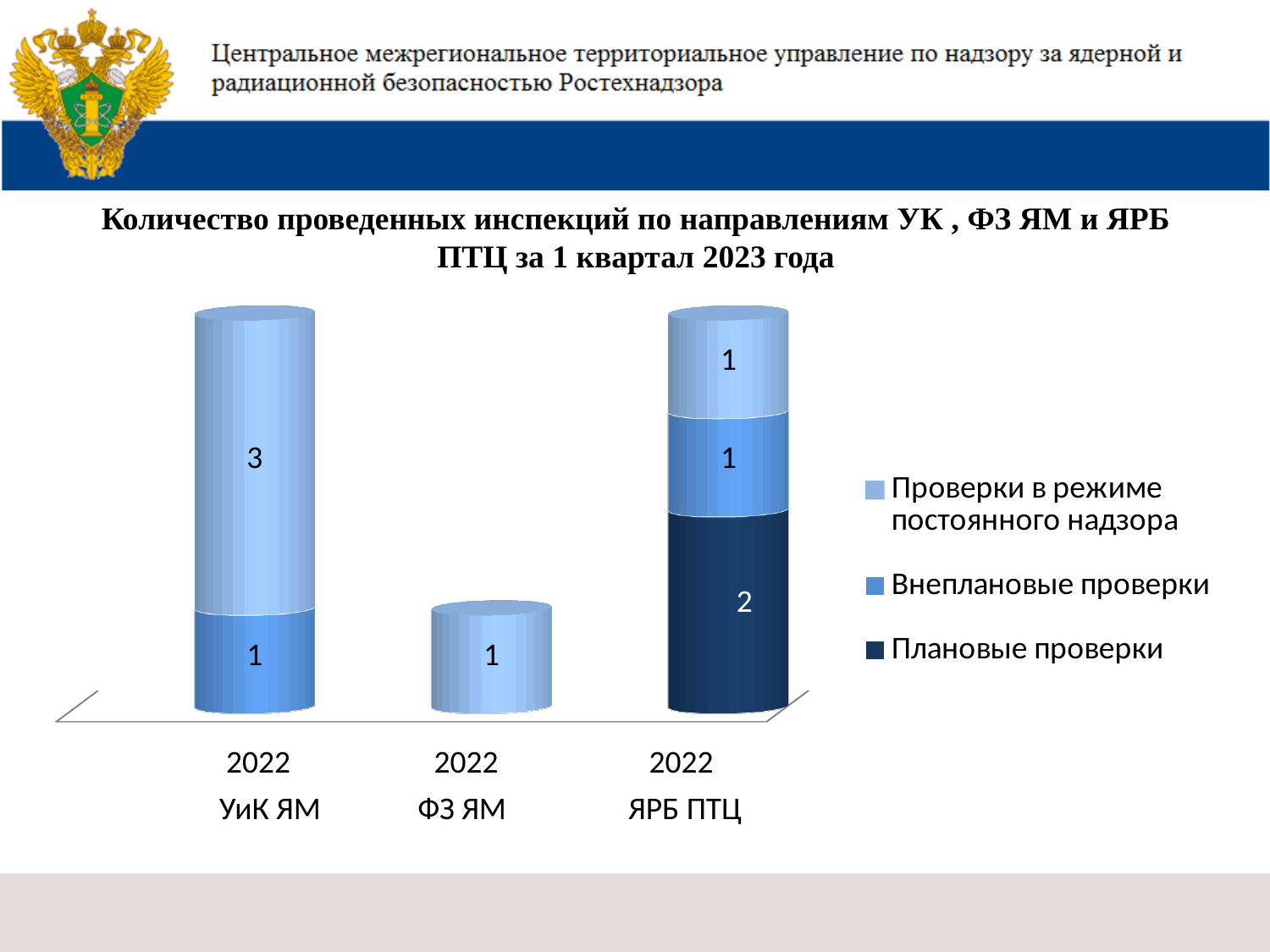
What kind of chart is shown on the slide? Stacked bar chart What is the difference between 'Проверки в режиме постоянного надзора' for УиК ЯМ and for ЯРБ ПТЦ? 2 What is the value of 'Проверки в режиме постоянного надзора' for УиК ЯМ? 3 What is the value of 'Внеплановые проверки' for УиК ЯМ? 1 What is the value of 'Проверки в режиме постоянного надзора' for ФЗ ЯМ? 1 What is the value of 'Плановые проверки' for ЯРБ ПТЦ? 2 What is the total of the stacked bar for ЯРБ ПТЦ? 4 How many categories are shown on the x axis? 3 Which category has the lowest total number of inspections? ФЗ ЯМ How many series does the legend list? 3 What is the value of 'Внеплановые проверки' for ЯРБ ПТЦ? 1 What is the total of the stacked bar for УиК ЯМ? 4